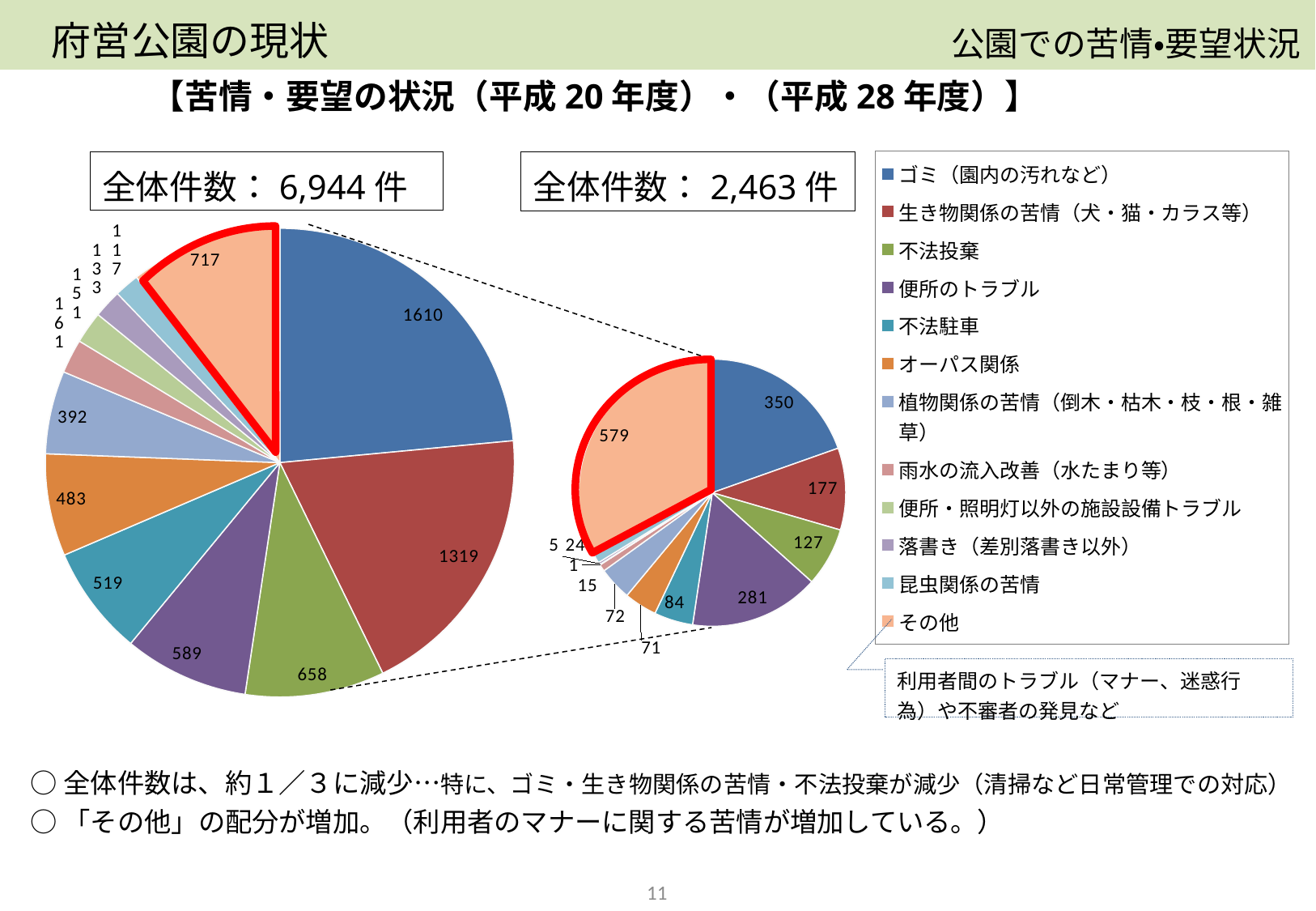
On the left pie chart (平成20年度), which category has the largest slice? ゴミ（園内の汚れなど） On the right pie chart (平成28年度), which is larger, the value for ゴミ（園内の汚れなど） or the value for 不法投棄? ゴミ（園内の汚れなど） On the right pie chart (平成28年度), which category has the largest slice? その他 On the left pie chart (平成20年度), what is the difference between the values for ゴミ（園内の汚れなど） and 生き物関係の苦情（犬・猫・カラス等）? 291 What kind of charts are shown on the slide? Pie charts On the left pie chart (平成20年度), what is the value for 生き物関係の苦情（犬・猫・カラス等）? 1319 What total number of cases (全体件数) is shown above the right pie chart (平成28年度)? 2,463 件 On the left pie chart (平成20年度), what is the value for ゴミ（園内の汚れなど）? 1610 On the right pie chart (平成28年度), what is the value for その他? 579 How many entries does the legend list? 12 On the right pie chart (平成28年度), what is the value for 便所のトラブル? 281 On the left pie chart (平成20年度), what is the value for その他? 717